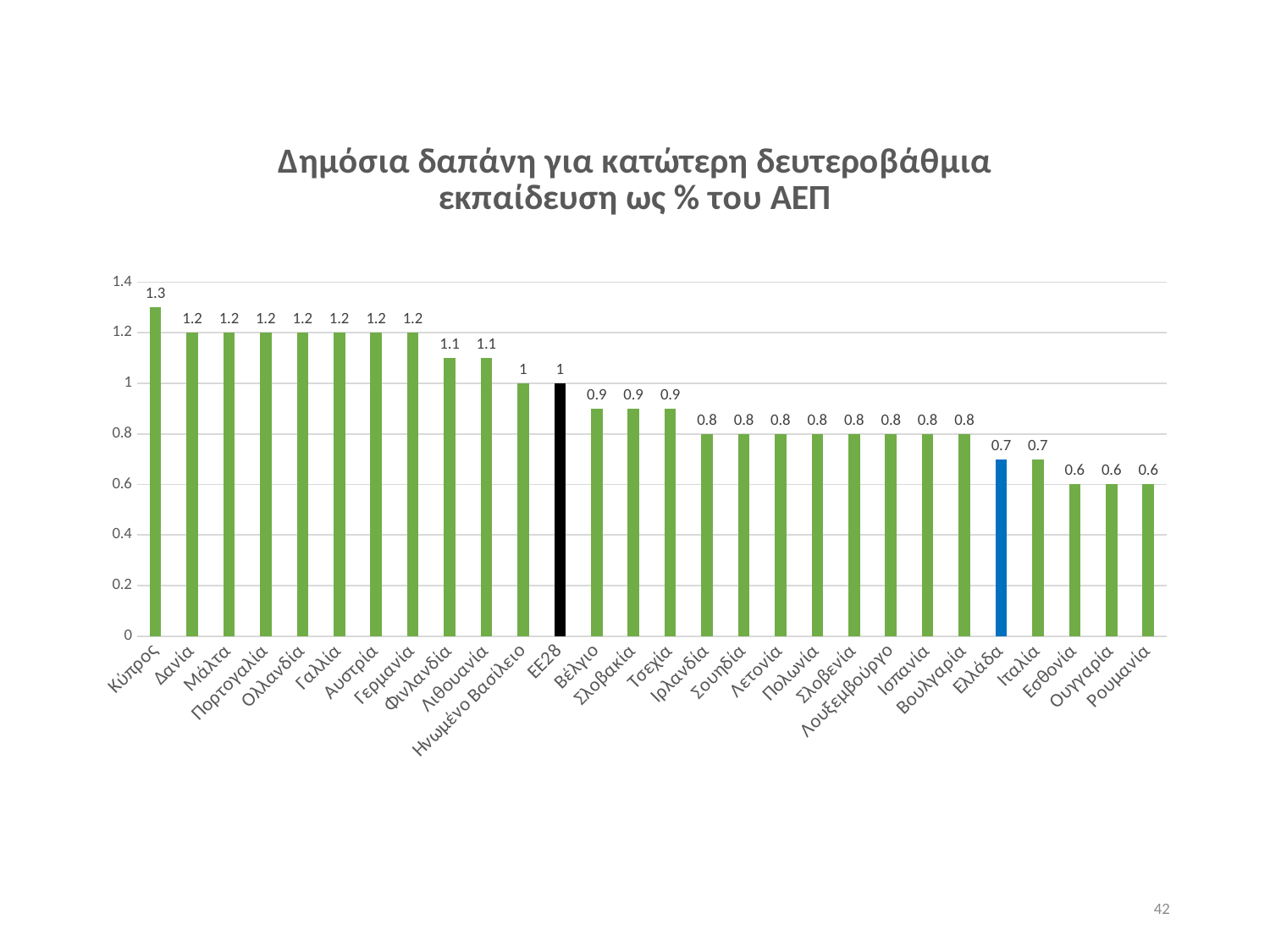
What is the value for Κύπρος? 1.3 Which is larger, the value for Γερμανία or the value for Ιταλία? Γερμανία What is the value for Ρουμανία? 0.6 What kind of chart is shown on the slide? Bar chart What colour is the bar for Ελλάδα? Blue What is the value for Ελλάδα? 0.7 Which category has the highest value? Κύπρος What is the difference between the values for Κύπρος and Ελλάδα? 0.6 Do the values rise or fall from left to right along the x axis? Fall How many categories are shown on the x axis? 28 What is the value for ΕΕ28? 1 What is the difference between the values for ΕΕ28 and Ελλάδα? 0.3